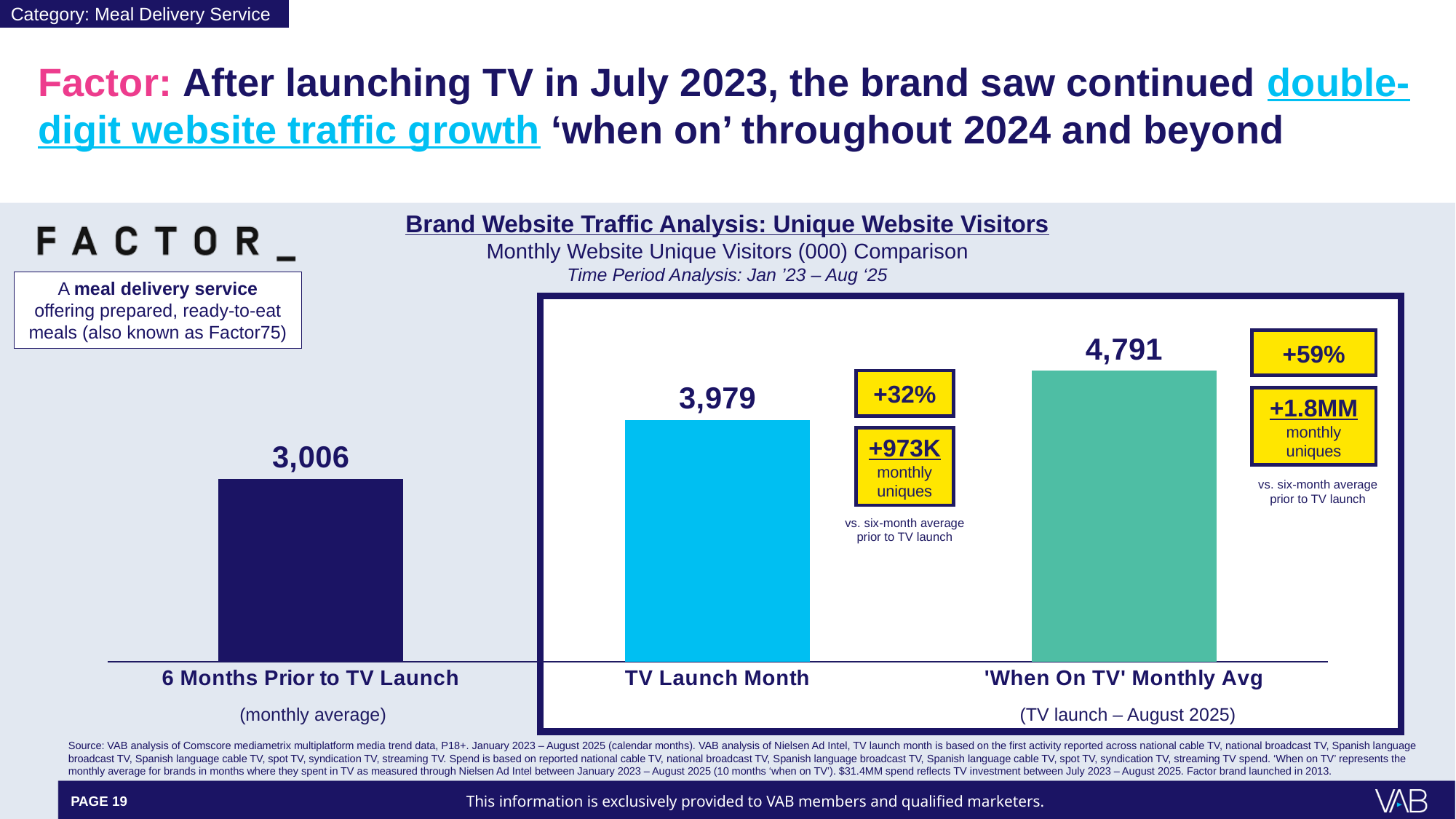
What is the value for ''When On TV' Monthly Avg'? 4,791 Do the values rise or fall from left to right across the categories? Rise Which is larger, the value for TV Launch Month or for 6 Months Prior to TV Launch? TV Launch Month What kind of chart is shown on the slide? Bar chart What is the difference between the 'When On TV' Monthly Avg and the 6 Months Prior to TV Launch values? 1,785 Which category has the lowest value? 6 Months Prior to TV Launch How many categories are shown in the chart? 3 Which category has the highest value? 'When On TV' Monthly Avg What is the value for 'TV Launch Month'? 3,979 What is the difference between the TV Launch Month and the 6 Months Prior to TV Launch values? 973 What percentage increase is shown for the 'When On TV' Monthly Avg versus the six-month average prior to TV launch? +59% What is the value for '6 Months Prior to TV Launch'? 3,006